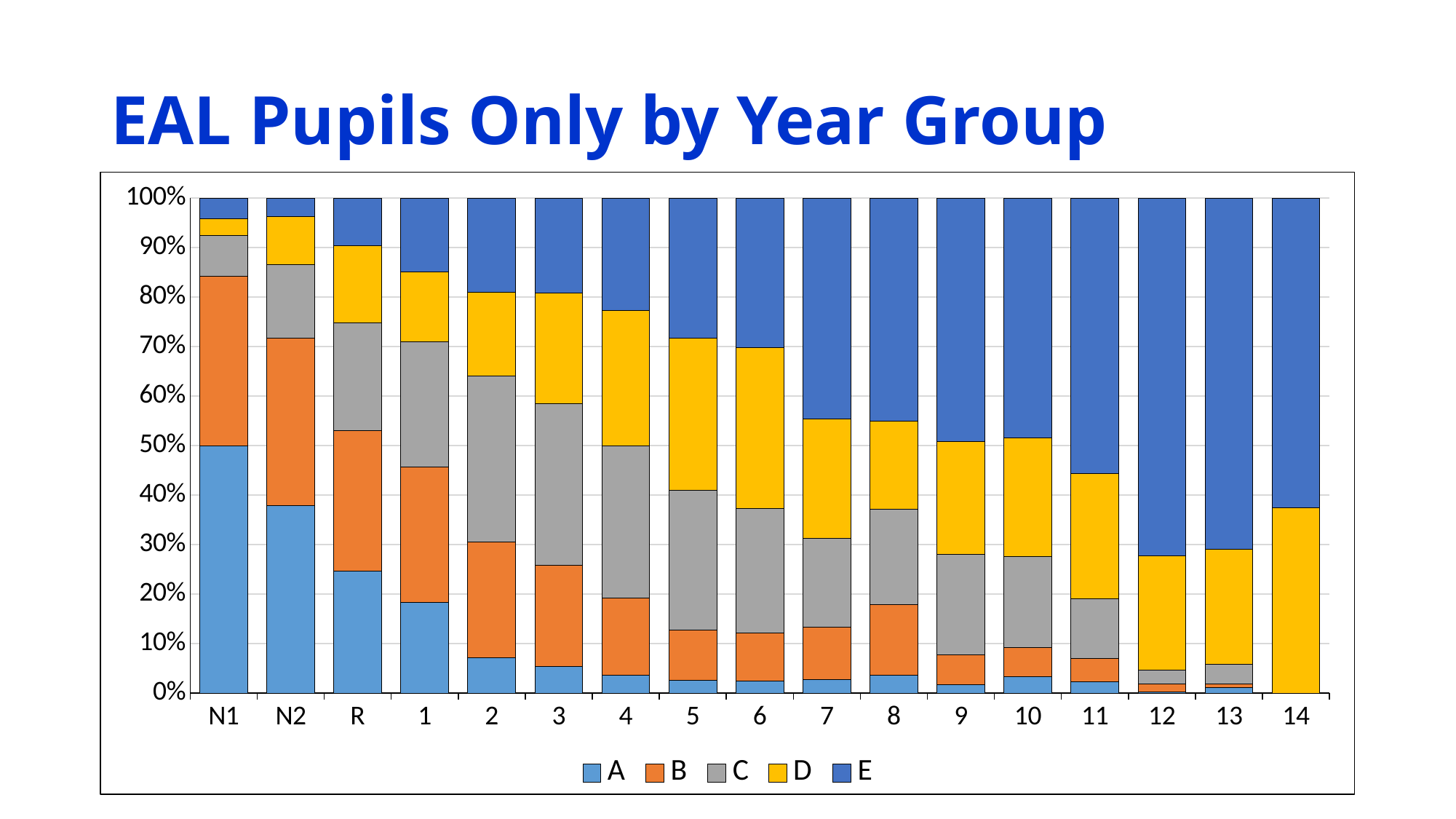
Does the share for series A rise or fall moving from N1 to 14 along the x axis? Fall What kind of chart is shown on the slide? Stacked bar chart What does each stacked bar total? 100% Is the share for series A in year group 2 greater or less than 10%? less Which year group has the largest share for series A? N1 How many series does the legend list? 5 Which is larger, the share for series A in N1 or in R? N1 Which series is shown in yellow in the legend? D Is the share for series A in N2 greater or less than 30%? greater How many year-group categories are shown on the x axis? 17 Which year group has the largest share for series E? 12 What is the title of the chart? EAL Pupils Only by Year Group